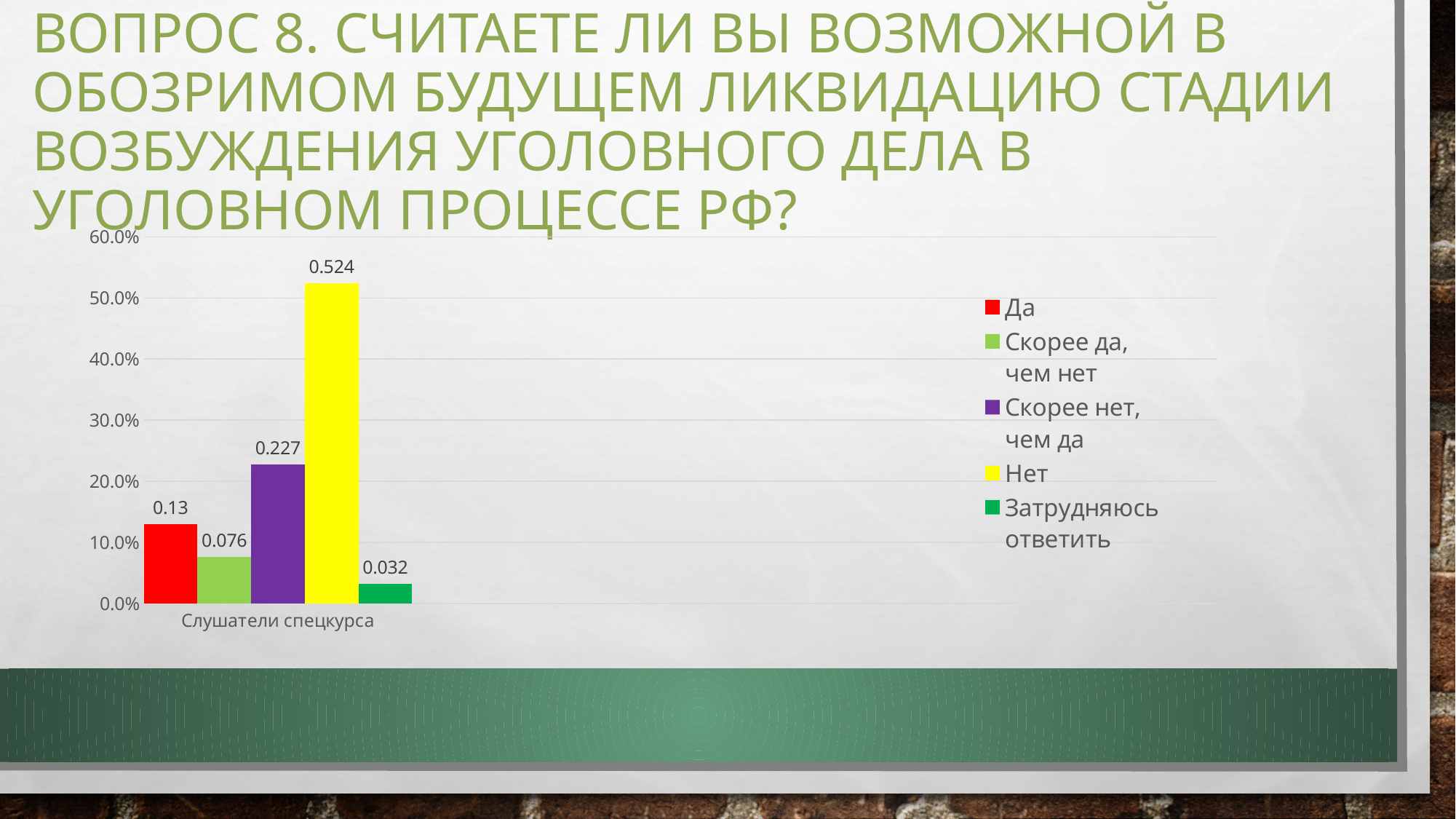
Which series has the highest value? Нет What is the value for the series "Скорее нет, чем да"? 0.227 What kind of chart is shown on the slide? bar chart What is the value for the series "Нет"? 0.524 What is the difference between the values for "Нет" and "Скорее нет, чем да"? 0.297 What is the label of the category on the x axis? Слушатели спецкурса How many series does the legend list? 5 Which series has the lowest value? Затрудняюсь ответить What is the value for the series "Да"? 0.13 Which is larger, the value for "Да" or the value for "Скорее да, чем нет"? Да What is the value for the series "Затрудняюсь ответить"? 0.032 Is the value for "Нет" greater or less than 50.0%? greater